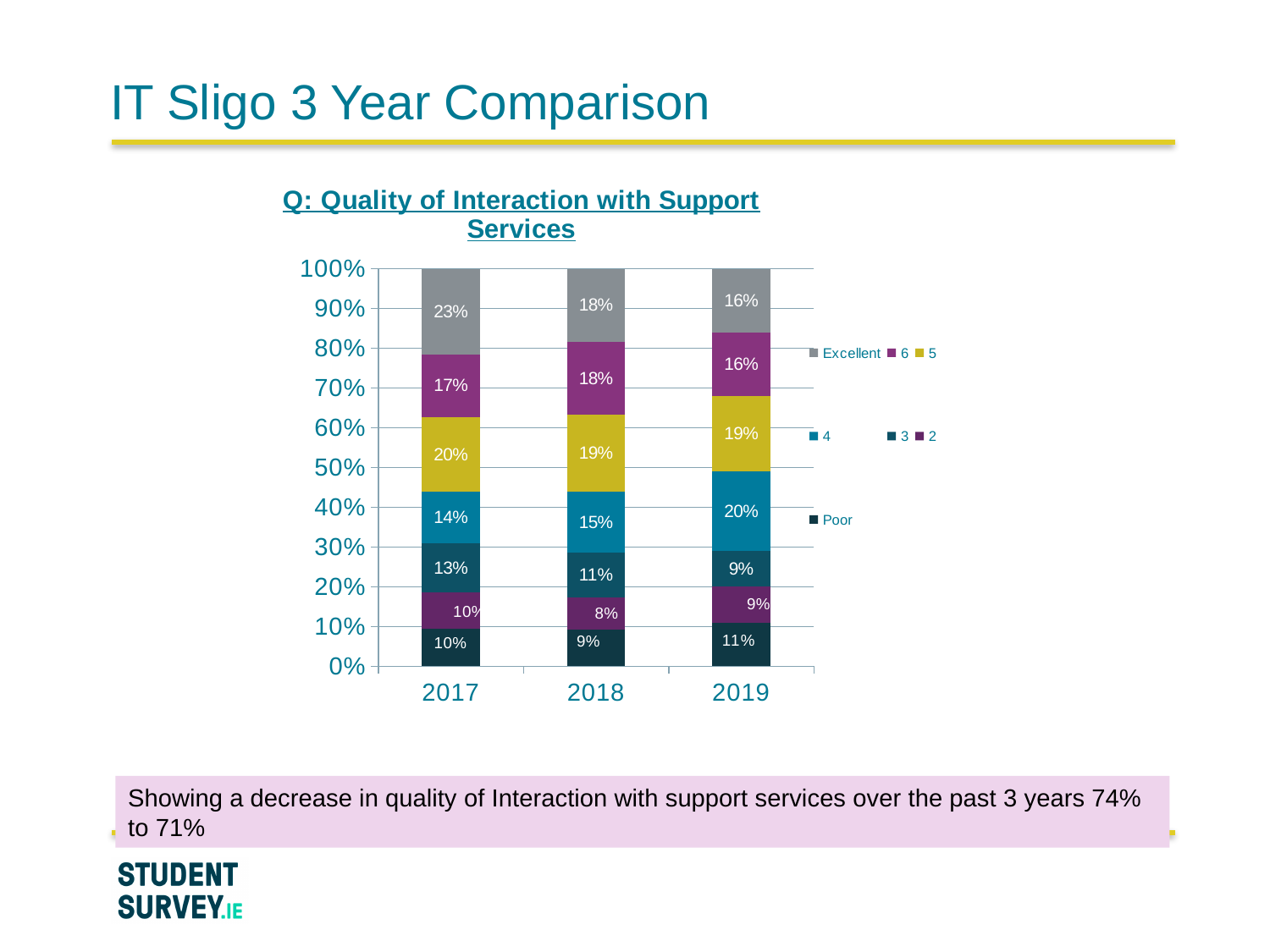
Which year has the highest Excellent value? 2017 How many years are shown on the x axis? 3 How many series does the legend list? 7 What is the Excellent value for 2017? 23% What kind of chart is shown on the slide? Stacked bar chart What is the difference between the Excellent value in 2017 and in 2019? 7% Which year has the lowest value for rating 2? 2018 What is the title of the chart? Q: Quality of Interaction with Support Services Does the Excellent value rise or fall from 2017 to 2019? Fall What is the value for rating 4 in 2018? 15% Is the value for rating 4 larger in 2019 or in 2017? 2019 What is the Poor value for 2019? 11%